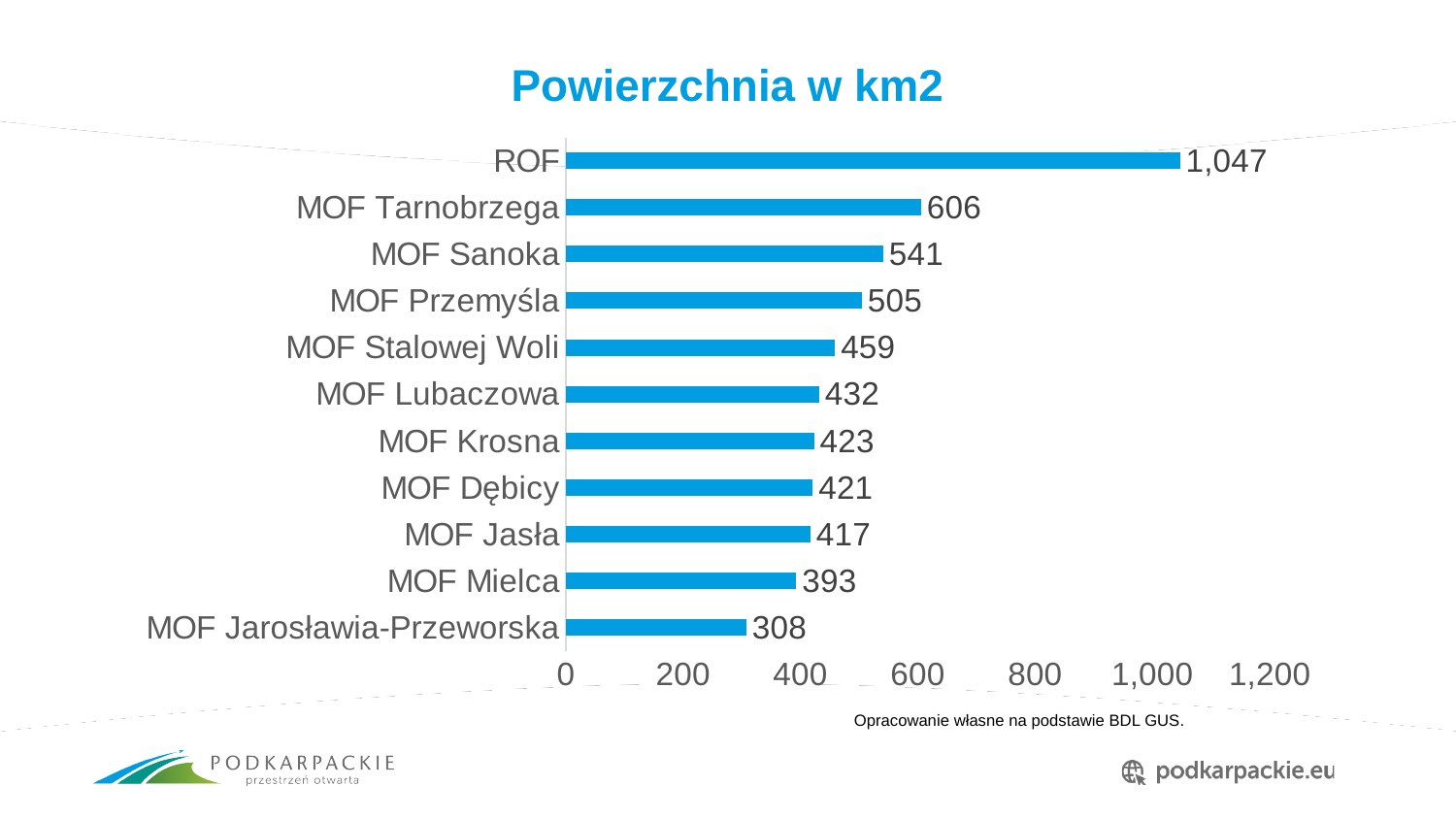
Which category has the lowest value? MOF Jarosławia-Przeworska Which category has the highest value? ROF Is the value for MOF Lubaczowa greater or less than 400? greater What is the value for ROF? 1,047 Which is larger, the value for MOF Przemyśla or the value for MOF Stalowej Woli? MOF Przemyśla What is the title of the chart? Powierzchnia w km2 What is the value for MOF Jarosławia-Przeworska? 308 How many categories are shown in the chart? 11 What kind of chart is shown on the slide? bar chart What is the difference between the values for MOF Tarnobrzega and MOF Sanoka? 65 What is the difference between the values for ROF and MOF Mielca? 654 What is the value for MOF Sanoka? 541